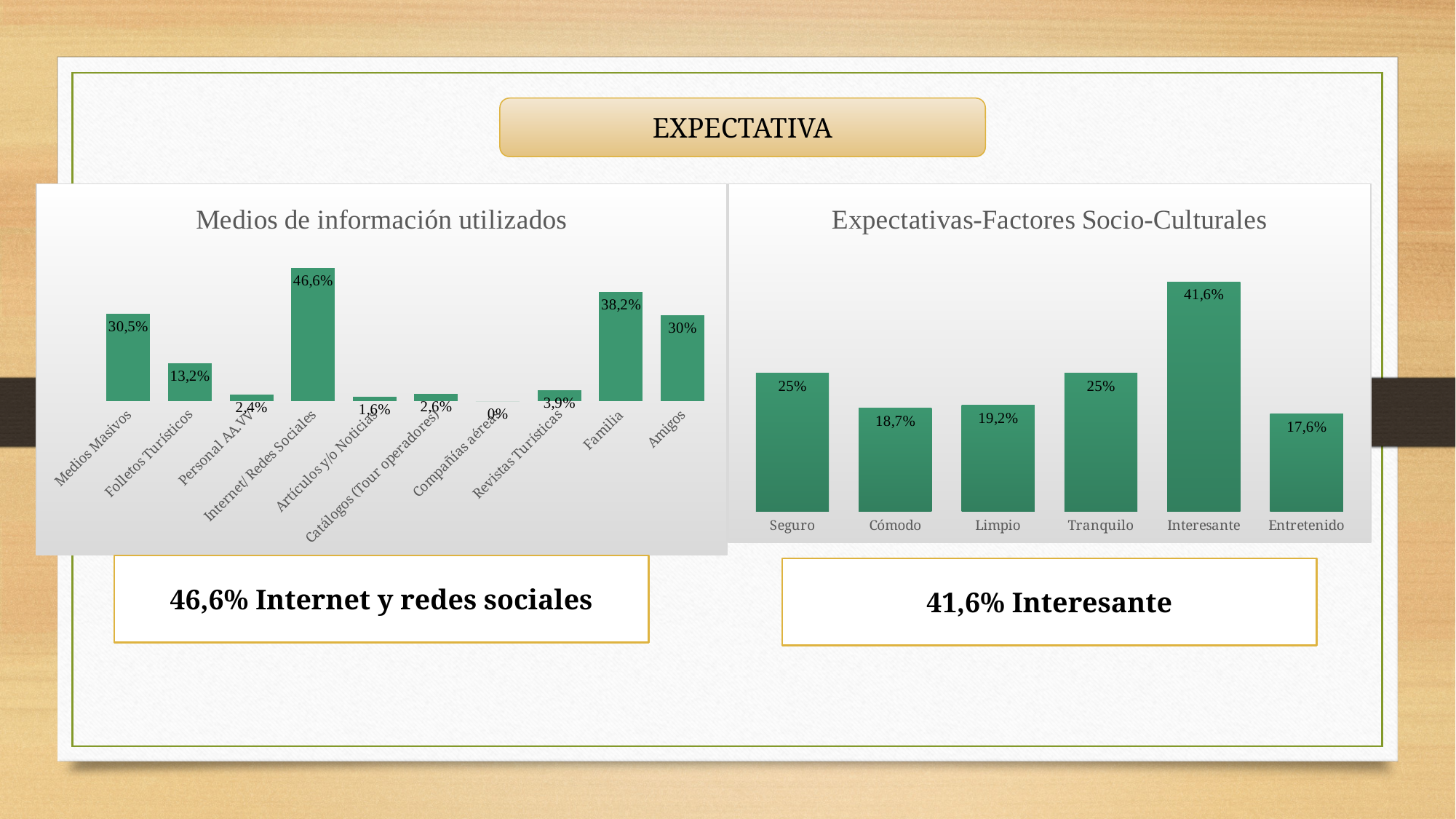
In the 'Medios de información utilizados' chart, what is the value for Internet/ Redes Sociales? 46,6% What type of chart is the 'Expectativas-Factores Socio-Culturales' chart? Bar chart How many categories are shown in the 'Expectativas-Factores Socio-Culturales' chart? 6 In the 'Medios de información utilizados' chart, which is larger, Familia or Amigos? Familia In the 'Medios de información utilizados' chart, what is the value for Familia? 38,2% In the 'Expectativas-Factores Socio-Culturales' chart, what is the value for Cómodo? 18,7% In the 'Expectativas-Factores Socio-Culturales' chart, what is the difference between Interesante and Tranquilo? 16,6% In the 'Expectativas-Factores Socio-Culturales' chart, which category has the lowest value? Entretenido In the 'Medios de información utilizados' chart, what is the difference between Medios Masivos and Folletos Turísticos? 17,3% In the 'Medios de información utilizados' chart, which category has the lowest value? Compañías aéreas How many categories are shown in the 'Medios de información utilizados' chart? 10 In the 'Expectativas-Factores Socio-Culturales' chart, which category has the highest value? Interesante